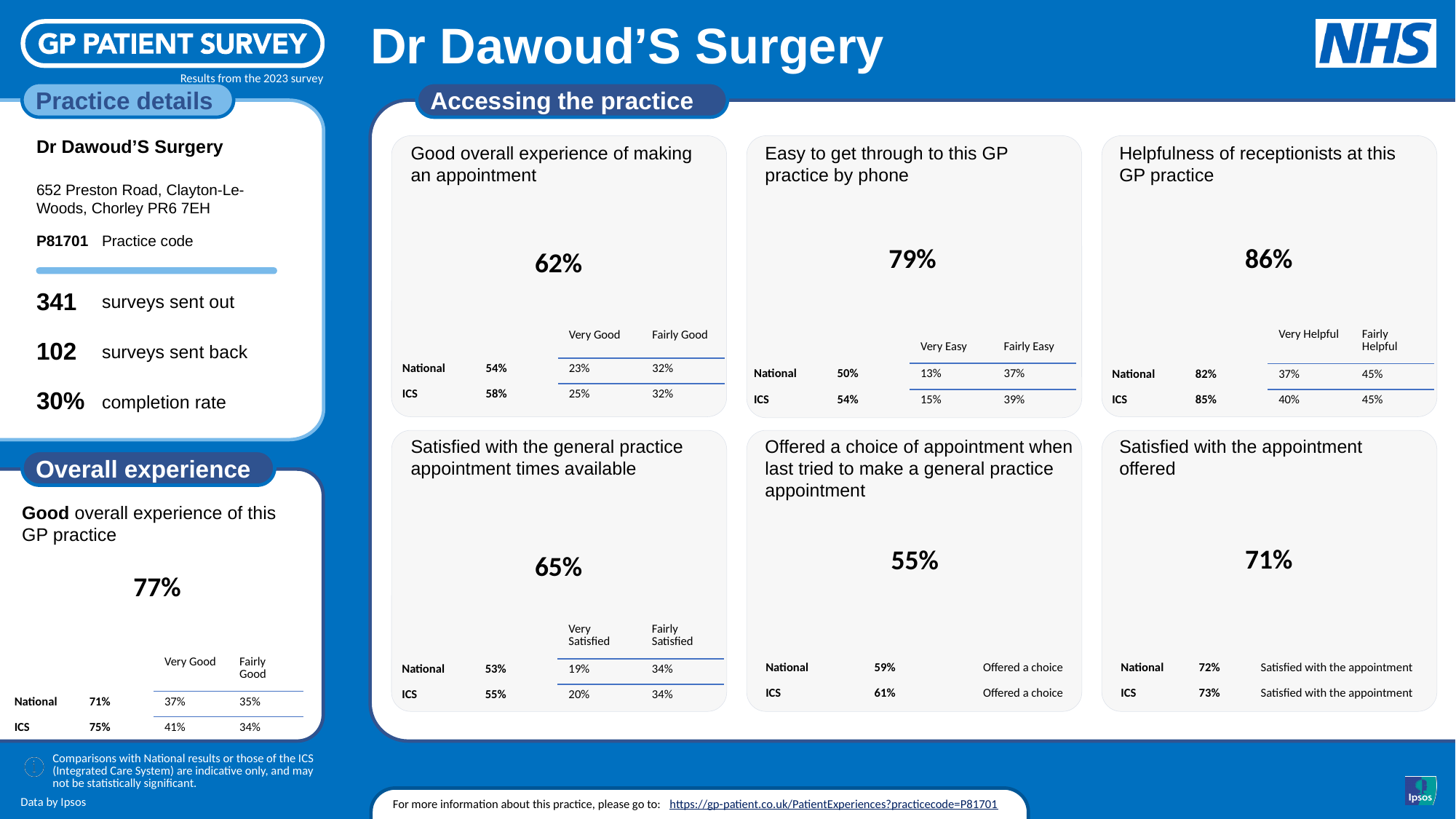
In the 'Satisfied with the general practice appointment times available' panel, what is the National 'Very Satisfied' value? 19% In the 'Helpfulness of receptionists at this GP practice' panel, what is the ICS value? 85% In the 'Offered a choice of appointment when last tried to make a general practice appointment' panel, what is the practice's headline percentage? 55% Among the six 'Accessing the practice' panels, which has the highest headline percentage? Helpfulness of receptionists at this GP practice Among the six 'Accessing the practice' panels, which has the lowest headline percentage? Offered a choice of appointment when last tried to make a general practice appointment In the 'Good overall experience of making an appointment' panel, what is the practice's headline percentage? 62% In the 'Easy to get through to this GP practice by phone' panel, what is the National value? 50% In the 'Satisfied with the appointment offered' panel, what is the difference between the practice's headline percentage and the National value? 1% In the 'Easy to get through to this GP practice by phone' panel, which is larger: the practice's headline percentage or the ICS value? The practice's headline percentage In the 'Good overall experience of this GP practice' panel, what is the ICS 'Very Good' value? 41% How many panels are shown under the 'Accessing the practice' heading? 6 In the 'Good overall experience of making an appointment' panel, what is the difference between the ICS and National values? 4%